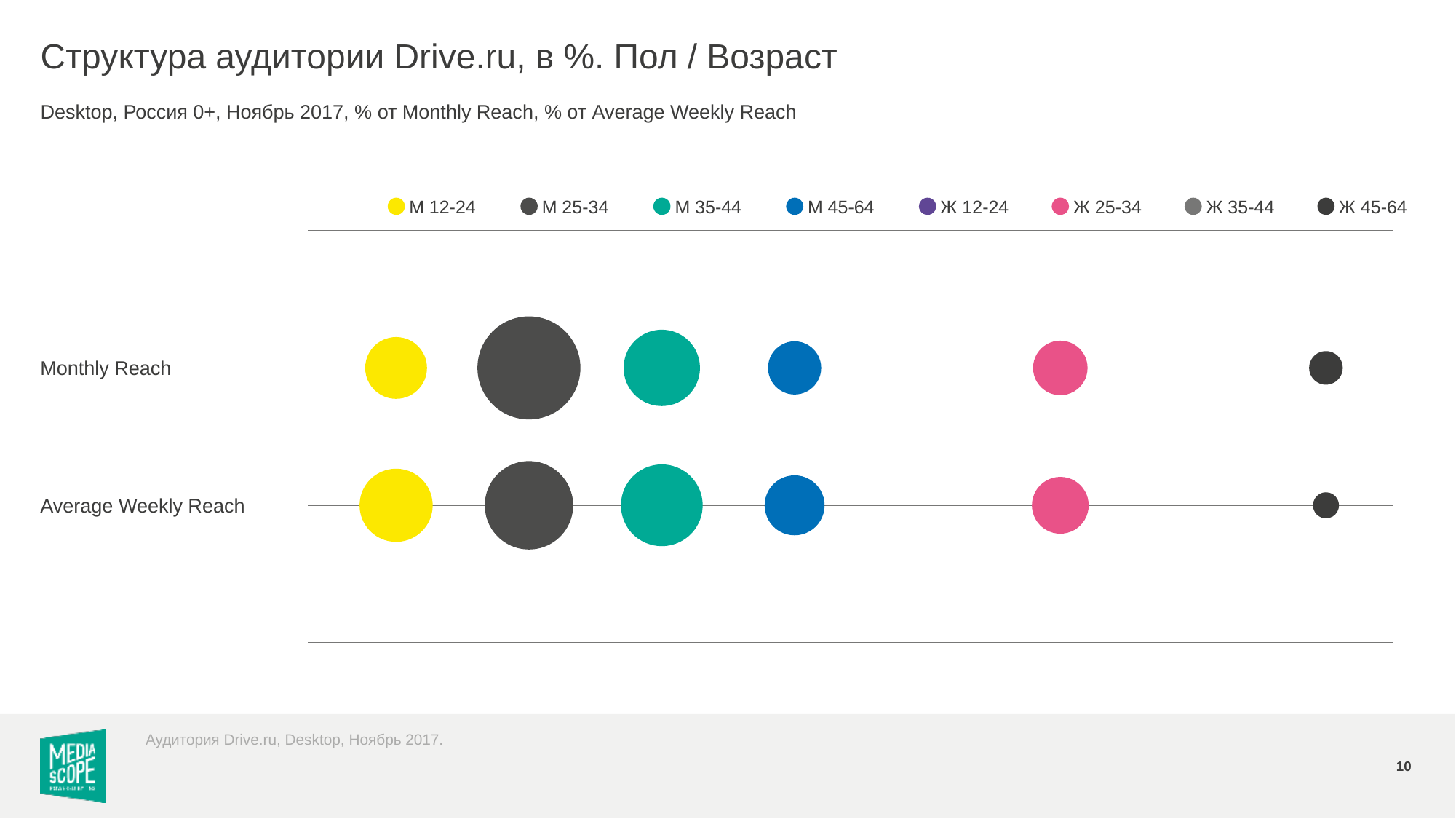
What is the title of the slide? Структура аудитории Drive.ru, в %. Пол / Возраст Which series has the largest bubble in the Monthly Reach row? М 25-34 In the Monthly Reach row, which bubble is larger: Ж 25-34 or Ж 45-64? Ж 25-34 How many series does the legend list? 8 What are the two row labels on the chart? Monthly Reach and Average Weekly Reach Which visible series has the smallest bubble in the Monthly Reach row? Ж 45-64 What kind of chart is shown on the slide? Bubble chart In the Monthly Reach row, which bubble is larger: М 25-34 or М 12-24? М 25-34 Which series has the largest bubble in the Average Weekly Reach row? М 25-34 In the Average Weekly Reach row, which bubble is larger: М 35-44 or М 45-64? М 35-44 How many rows (categories) are plotted on the chart? 2